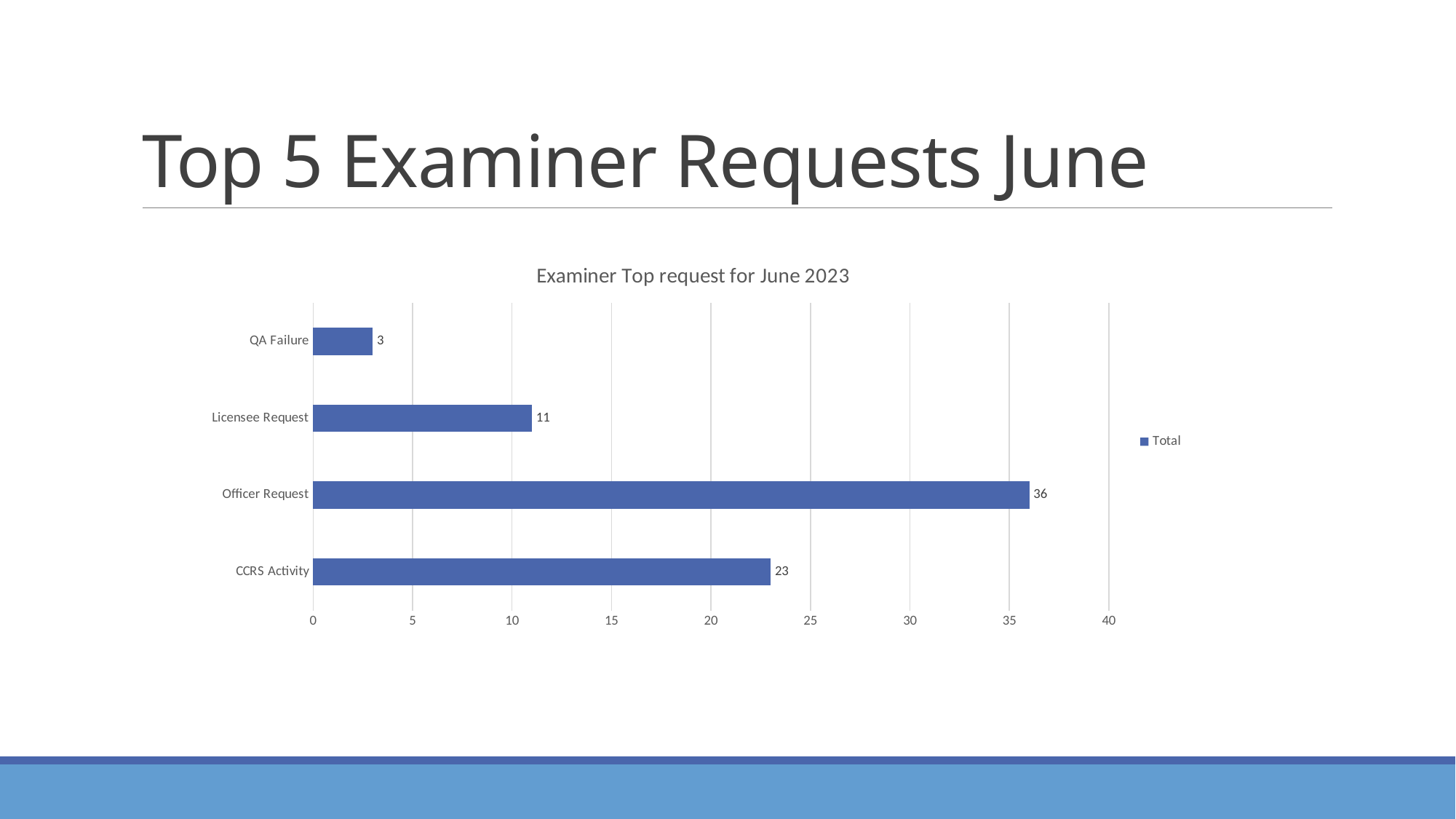
What kind of chart is shown on the slide? Bar chart Which category has the highest value? Officer Request Which category has the lowest value? QA Failure What is the value for CCRS Activity? 23 What is the value for QA Failure? 3 Is the value for Officer Request greater or less than 35? greater How many categories are shown in the chart? 4 What is the difference between the values for Officer Request and CCRS Activity? 13 What is the value for Licensee Request? 11 What is the value for Officer Request? 36 Which is larger, the value for Licensee Request or the value for CCRS Activity? CCRS Activity What is the title of the chart? Examiner Top request for June 2023